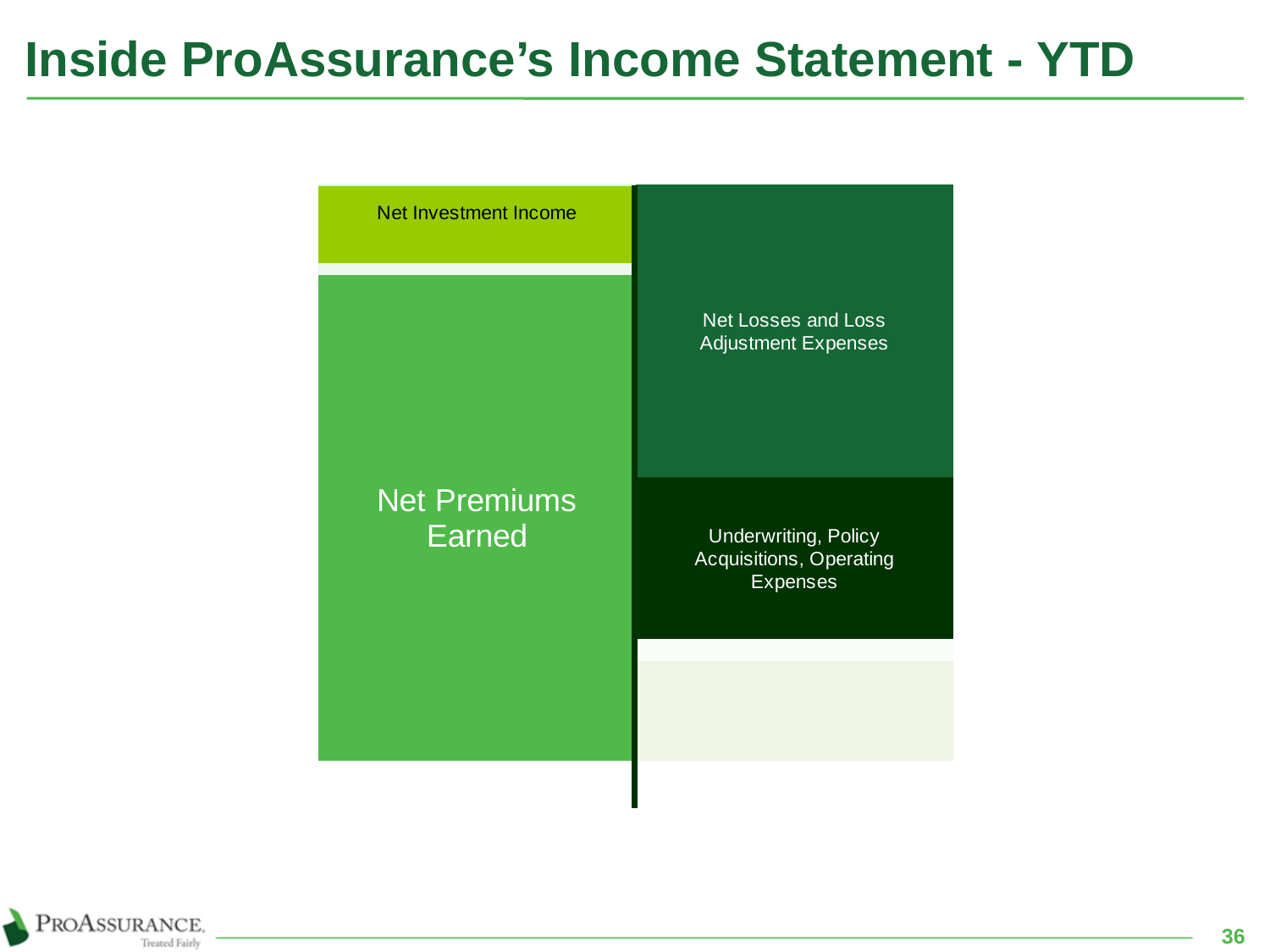
Which labeled segment in the left bar is larger, Net Premiums Earned or Net Investment Income? Net Premiums Earned Which segment is at the top of the left bar? Net Investment Income What is the title of the slide containing the chart? Inside ProAssurance's Income Statement - YTD How many labeled segments are in the right bar? 2 How many labeled segments are in the left bar? 2 How many labeled segments are there in total across both bars? 4 Which labeled segment in the right bar is larger, Net Losses and Loss Adjustment Expenses or Underwriting, Policy Acquisitions, Operating Expenses? Net Losses and Loss Adjustment Expenses Which labeled segment appears directly below Net Losses and Loss Adjustment Expenses in the right bar? Underwriting, Policy Acquisitions, Operating Expenses What kind of chart is shown on the slide? Bar chart Which labeled segment is the smallest in the chart? Net Investment Income Which labeled segment is the largest in the chart? Net Premiums Earned